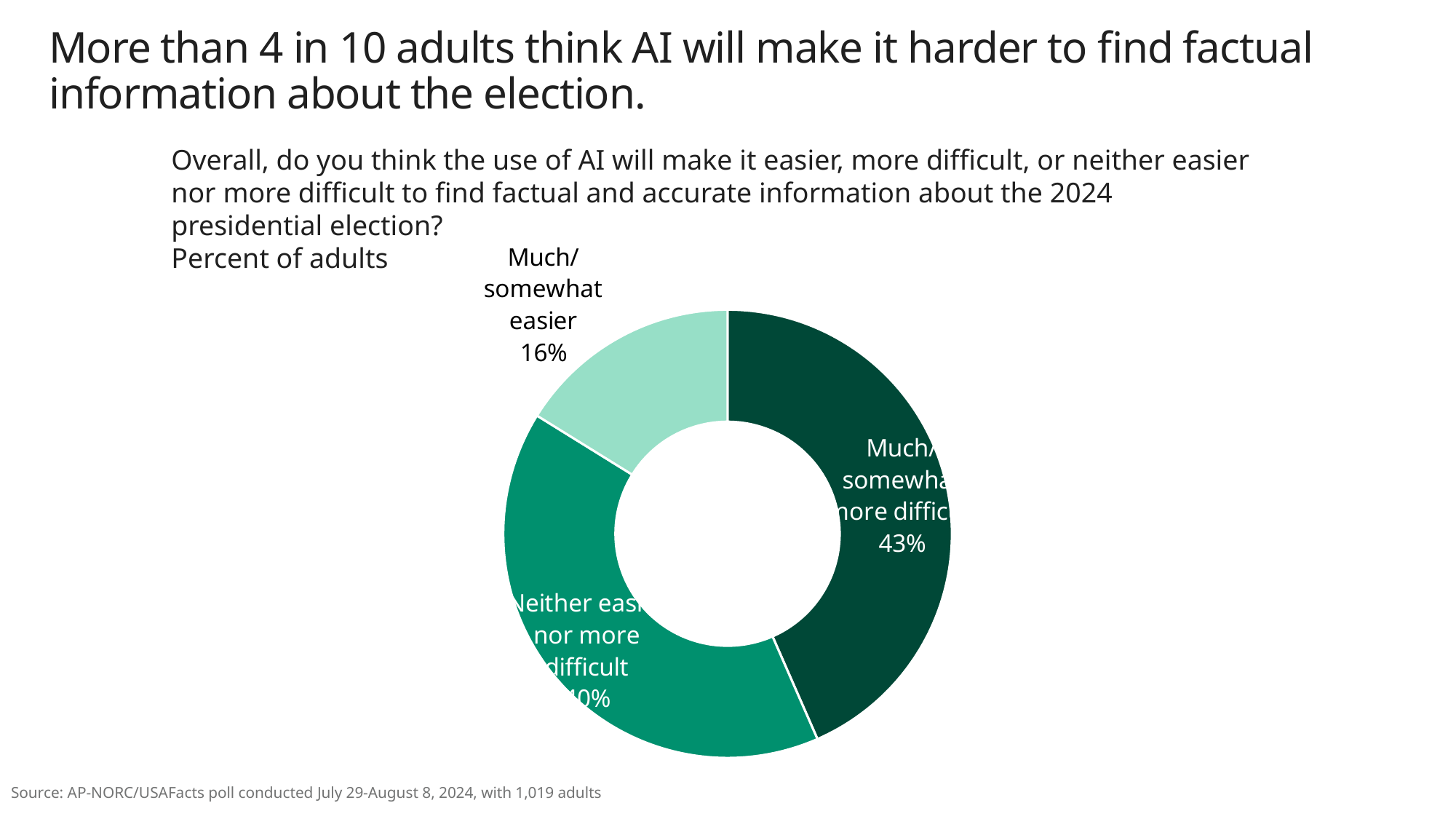
What percentage of adults think AI will make it much/somewhat easier to find factual information about the election? 16% According to the source note, how many adults were polled? 1,019 adults Which is larger: the share for 'Neither easier nor more difficult' or the share for 'Much/somewhat easier'? Neither easier nor more difficult What percentage of adults think AI will make it much/somewhat more difficult to find factual information about the election? 43% Which is larger: the share for 'Much/somewhat more difficult' or the share for 'Neither easier nor more difficult'? Much/somewhat more difficult Is the share for 'Much/somewhat more difficult' greater or less than 40%? greater Which response category has the largest share of the donut chart? Much/somewhat more difficult What kind of chart is shown on the slide? Donut (pie) chart How many response categories are shown in the chart? 3 Which slice of the chart is shown in the darkest green? Much/somewhat more difficult What is the difference in percentage points between the 'Much/somewhat more difficult' and 'Much/somewhat easier' slices? 27 percentage points Which response category has the smallest share of the donut chart? Much/somewhat easier